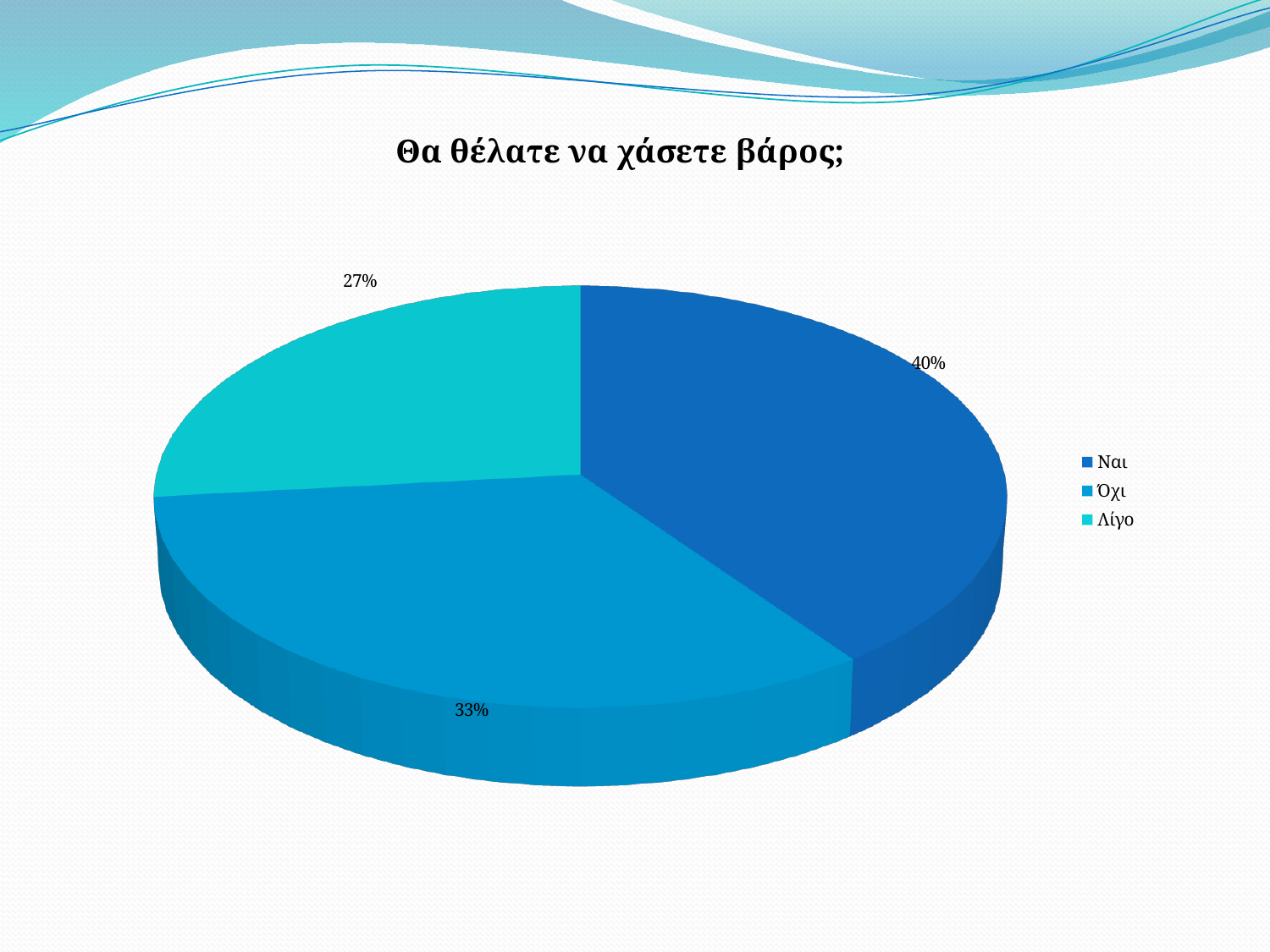
What is the title of the chart? Θα θέλατε να χάσετε βάρος; Which category has the largest slice of the pie? Ναι What is the difference in percentage points between the Ναι and Όχι slices? 7 Which legend entry is listed first? Ναι How many categories are shown in the pie chart? 3 What share of the pie does Λίγο represent? 27% Which category has the smallest slice of the pie? Λίγο What share of the pie does Όχι represent? 33% What kind of chart is shown on the slide? Pie chart Which slice is larger, Όχι or Λίγο? Όχι What is the difference in percentage points between the Ναι and Λίγο slices? 13 What share of the pie does Ναι represent? 40%